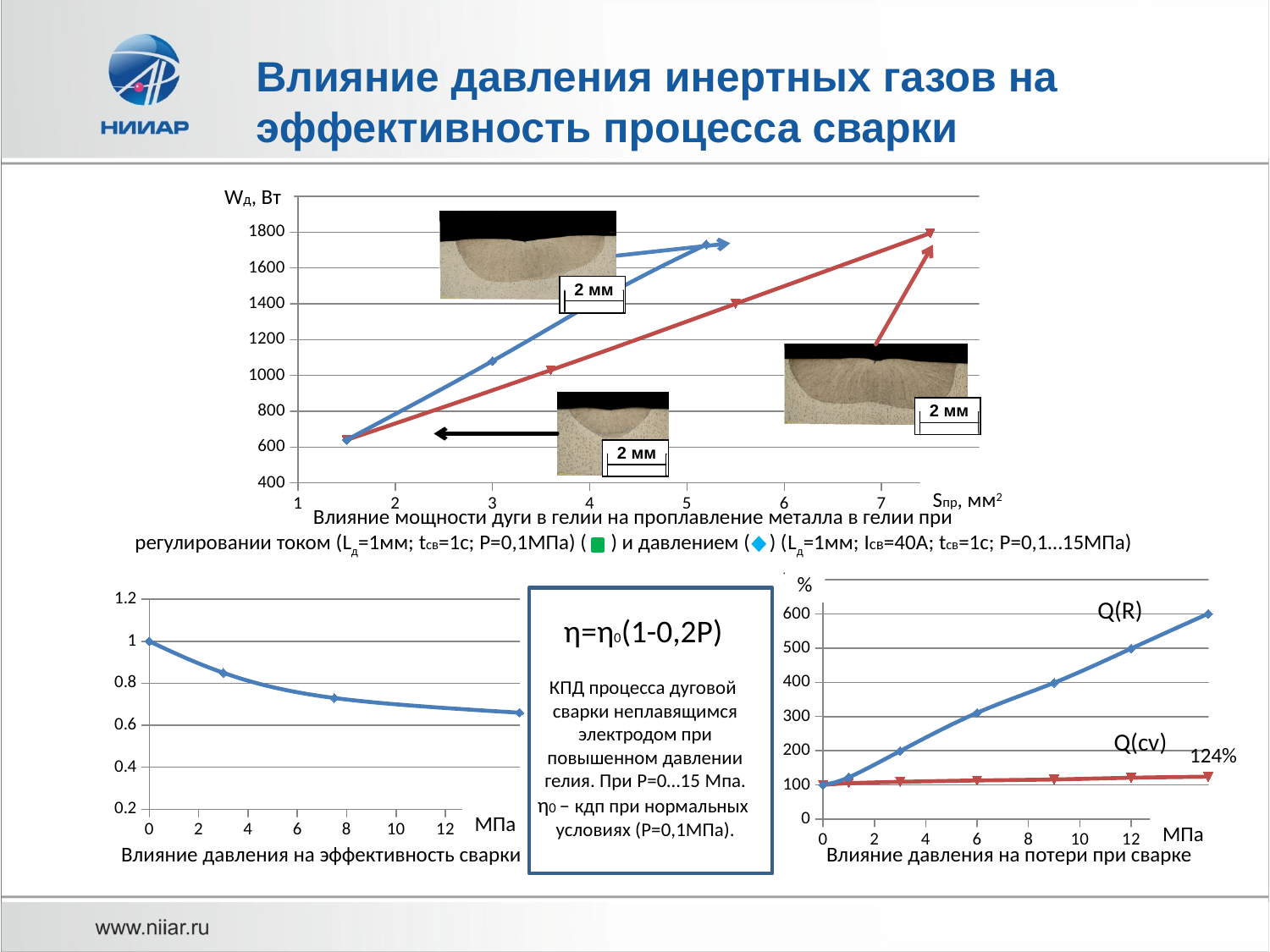
How many series are plotted in the bottom-right chart 'Влияние давления на потери при сварке'? 2 In the bottom-left chart 'Влияние давления на эффективность сварки', what is the value at 0 МПа? 1 In the bottom-left chart 'Влияние давления на эффективность сварки', is the value at 12 МПа greater or less than 0.8? less What is the label of the vertical axis of the top chart? Wд, Вт In the top chart, is the value of the blue series at Sпр = 3 мм² greater or less than 1000 Вт? greater In the bottom-left chart 'Влияние давления на эффективность сварки', do the values rise or fall as pressure increases along the x axis? fall In the bottom-right chart 'Влияние давления на потери при сварке', which series is higher at 12 МПа, Q(R) or Q(cv)? Q(R) In the bottom-right chart 'Влияние давления на потери при сварке', what value is labelled at the end of the Q(cv) line? 124% How many charts are shown on the slide? 3 What kind of chart is 'Влияние давления на эффективность сварки' (bottom left)? line chart In the bottom-right chart 'Влияние давления на потери при сварке', does Q(R) rise or fall as pressure increases? rise